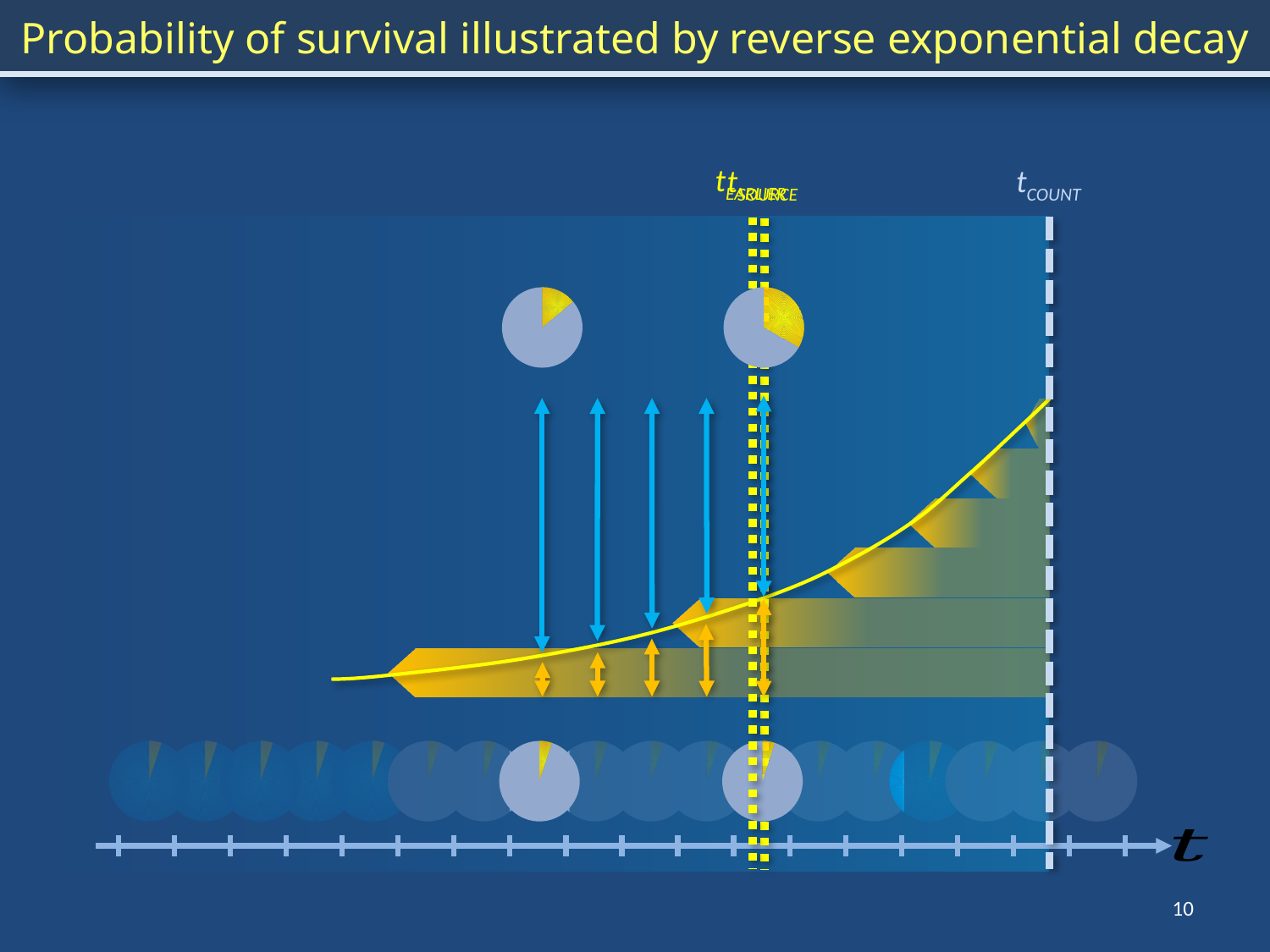
What is the title of the slide's chart? Probability of survival illustrated by reverse exponential decay Does the yellow curve rise or fall as t increases along the x axis? rise What label is shown on the horizontal axis of the chart? t